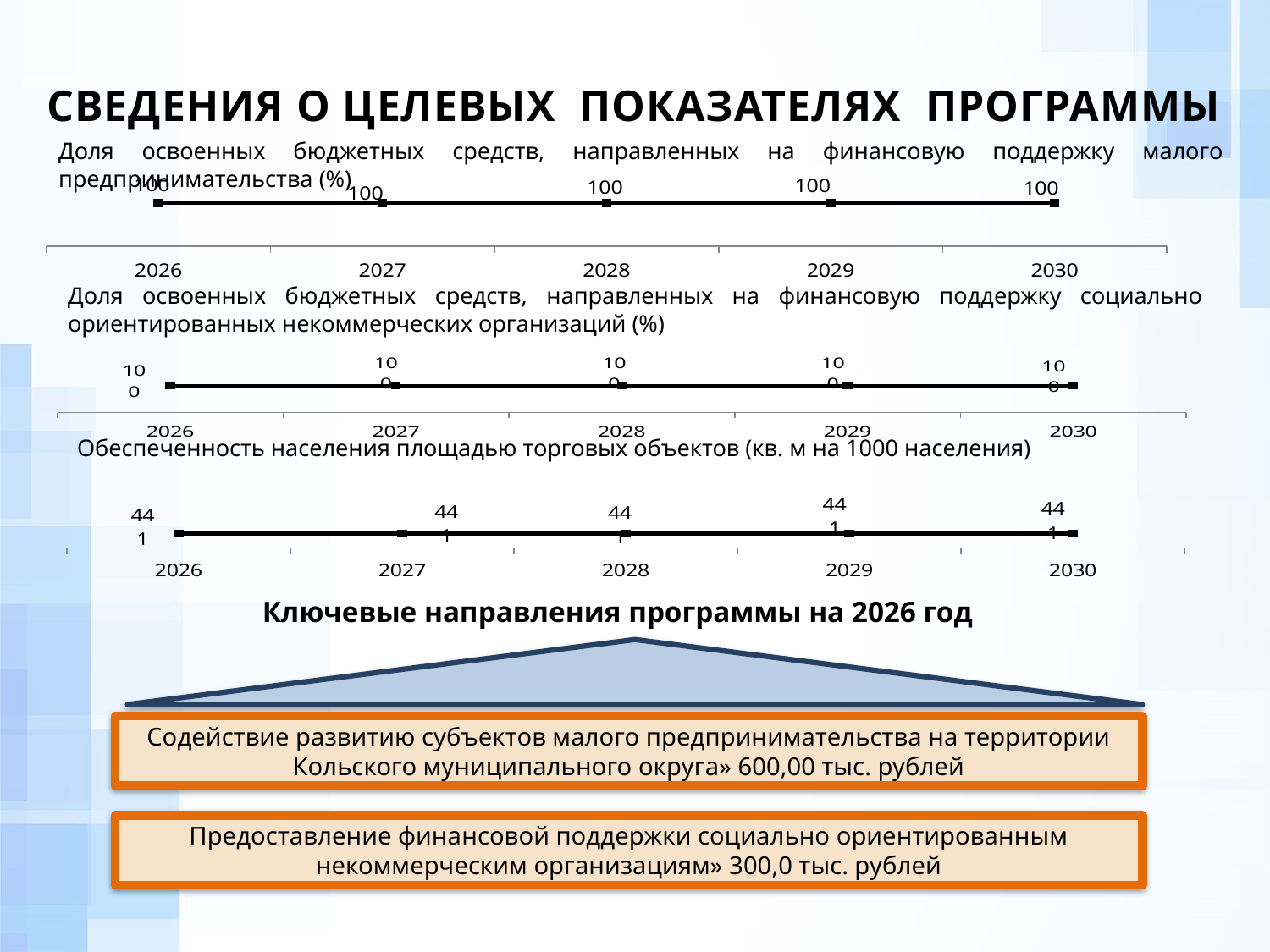
How many data points are plotted in the bottom chart (retail floor space per 1000 population)? 5 How many years are plotted on the x axis of the top chart (share of budget funds for small business support)? 5 In the bottom chart (retail floor space per 1000 population), what is the value for 2027? 441 In the middle chart (share of budget funds for socially oriented non-profit organisations), do the values rise, fall or stay flat across the years? stay flat In the top chart (share of budget funds for small business support), what is the value for 2026? 100 In the middle chart (share of budget funds for socially oriented non-profit organisations), what is the difference between the 2026 and 2030 values? 0 What is the first year shown on the x axis of the bottom chart (retail floor space per 1000 population)? 2026 In the top chart (share of budget funds for small business support), do the values rise, fall or stay flat from 2026 to 2030? stay flat In the top chart (share of budget funds for small business support), what is the value for 2030? 100 In the middle chart (share of budget funds for socially oriented non-profit organisations), what is the value for 2028? 100 What kind of chart is the top chart (share of budget funds for small business support)? line chart In the bottom chart (retail floor space per 1000 population), what is the value for 2030? 441